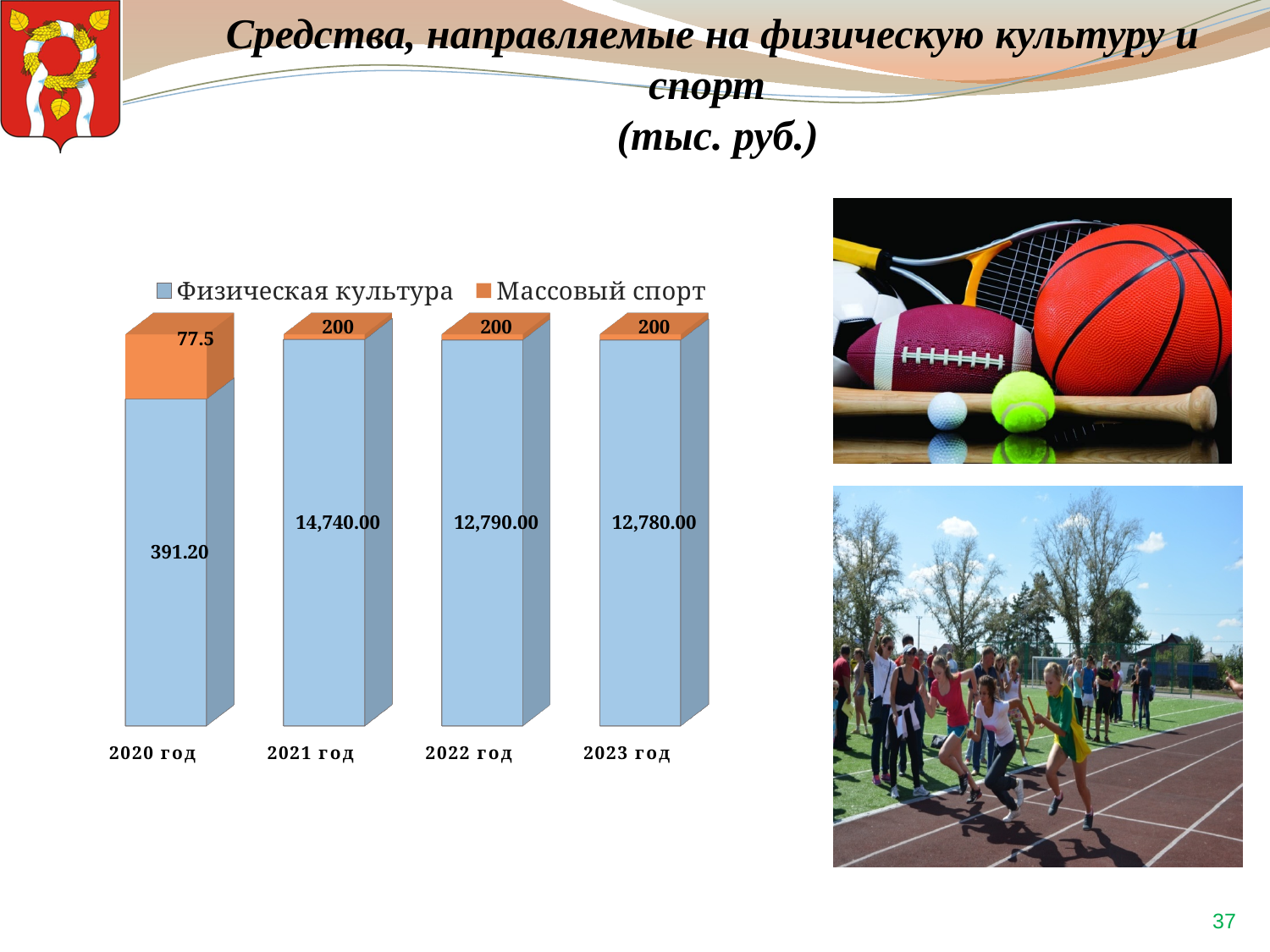
What is the value for Массовый спорт in 2020 год? 77.5 Which series is shown in orange in the legend? Массовый спорт How many series does the legend list? 2 What is the total of the stacked bar for 2022 год? 12,990.00 How many categories (years) are shown on the x axis? 4 What is the value for Физическая культура in 2023 год? 12,780.00 What is the value for Физическая культура in 2021 год? 14,740.00 In which year is the value for Физическая культура lowest? 2020 год What is the difference between the Физическая культура values for 2021 год and 2022 год? 1,950.00 Which is larger: the Массовый спорт value for 2020 год or for 2021 год? 2021 год In which year is the value for Физическая культура highest? 2021 год What kind of chart is shown on the slide? stacked bar chart